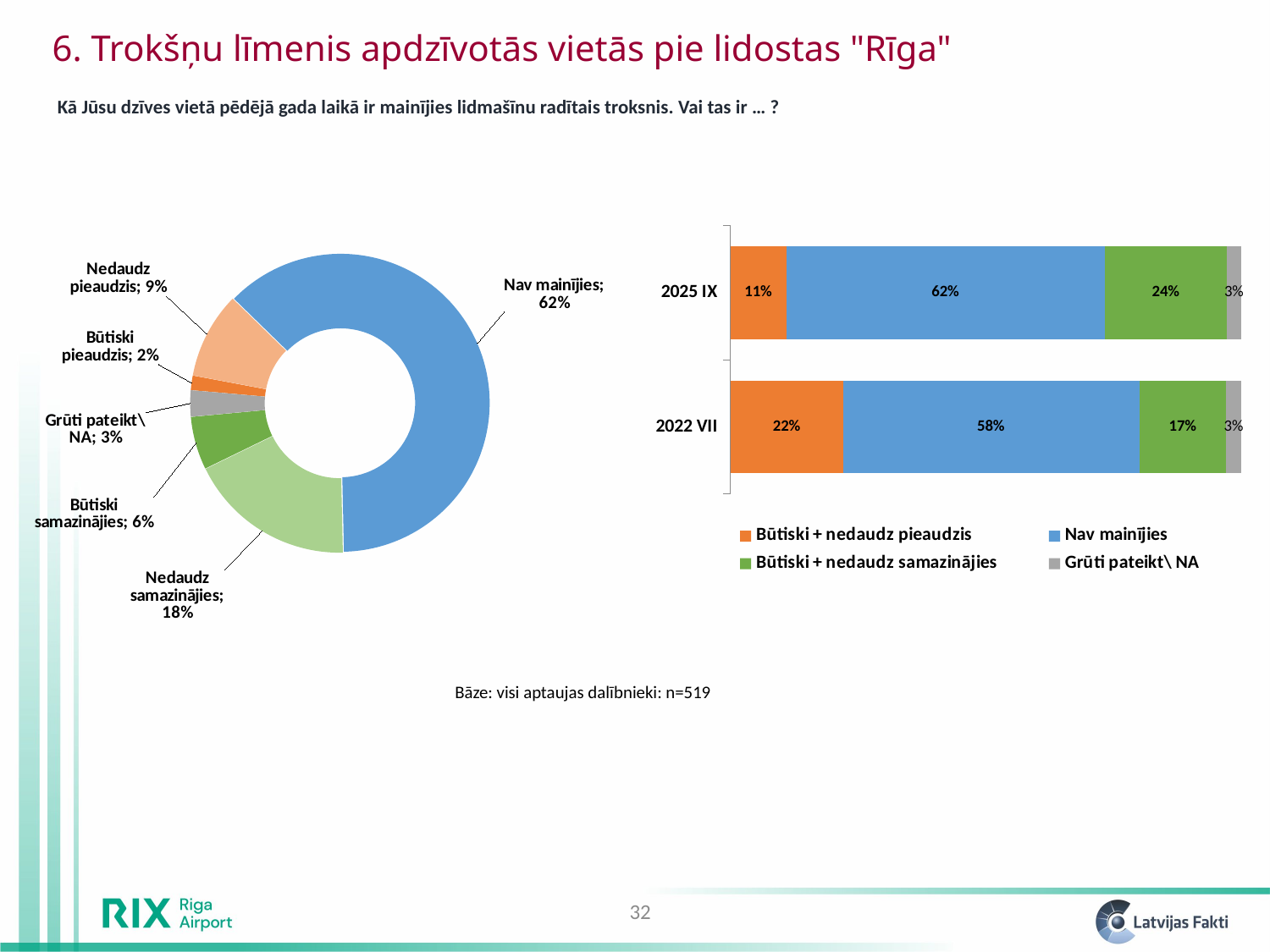
In the doughnut chart on the left, what share of respondents answered "Nav mainījies"? 62% In the stacked bar chart on the right, which year has the larger value for "Būtiski + nedaudz samazinājies", 2025 IX or 2022 VII? 2025 IX In the stacked bar chart on the right, how many series does the legend list? 4 In the stacked bar chart on the right, what colour represents "Grūti pateikt\ NA"? Grey In the doughnut chart on the left, what is the difference between "Nedaudz samazinājies" and "Nedaudz pieaudzis"? 9% In the stacked bar chart on the right, what is the value for "Būtiski + nedaudz pieaudzis" in 2025 IX? 11% In the doughnut chart on the left, what is the value for "Nedaudz samazinājies"? 18% What type of chart is shown on the right side of the slide? Stacked bar chart In the doughnut chart on the left, how many categories are shown? 6 In the doughnut chart on the left, which category has the smallest share? Būtiski pieaudzis In the stacked bar chart on the right, what is the value for "Nav mainījies" in 2022 VII? 58% In the stacked bar chart on the right, by how much did "Būtiski + nedaudz pieaudzis" change from 2022 VII to 2025 IX? It decreased by 11 percentage points (from 22% to 11%)